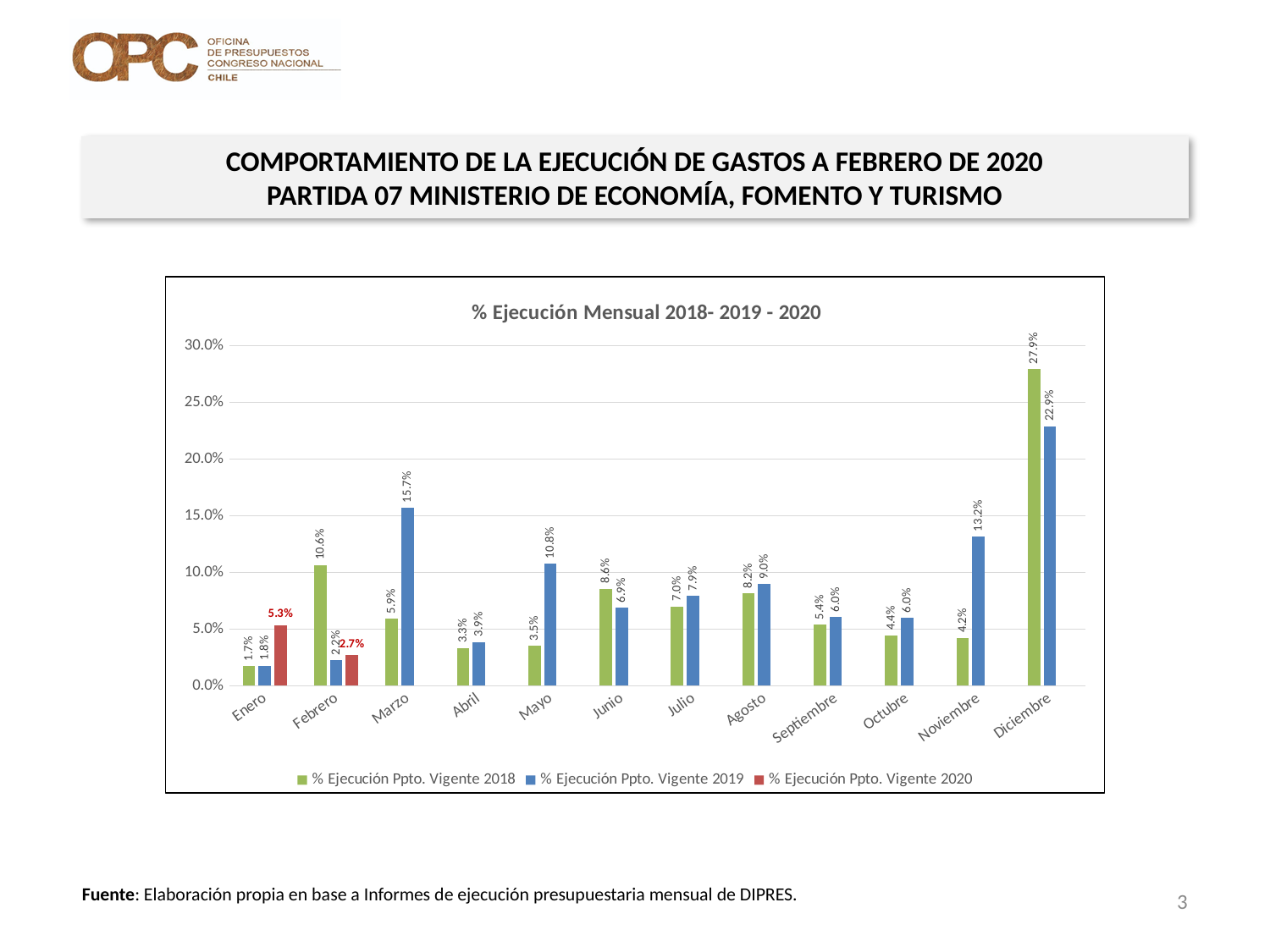
What is the value of % Ejecución Ppto. Vigente 2020 for Enero? 5.3% Which month has the highest value for % Ejecución Ppto. Vigente 2018? Diciembre What kind of chart is shown on the slide? Bar chart How many months are shown on the x axis? 12 For Junio, which series is larger: % Ejecución Ppto. Vigente 2018 or 2019? % Ejecución Ppto. Vigente 2018 What is the value of % Ejecución Ppto. Vigente 2019 for Noviembre? 13.2% What is the difference between the 2018 and 2019 values for Diciembre? 5.0 percentage points Which month has the lowest value for % Ejecución Ppto. Vigente 2019? Enero How many series does the legend list? 3 What is the difference between the 2019 and 2018 values for Marzo? 9.8 percentage points What is the title of the chart? % Ejecución Mensual 2018- 2019 - 2020 What is the value of % Ejecución Ppto. Vigente 2019 for Marzo? 15.7%